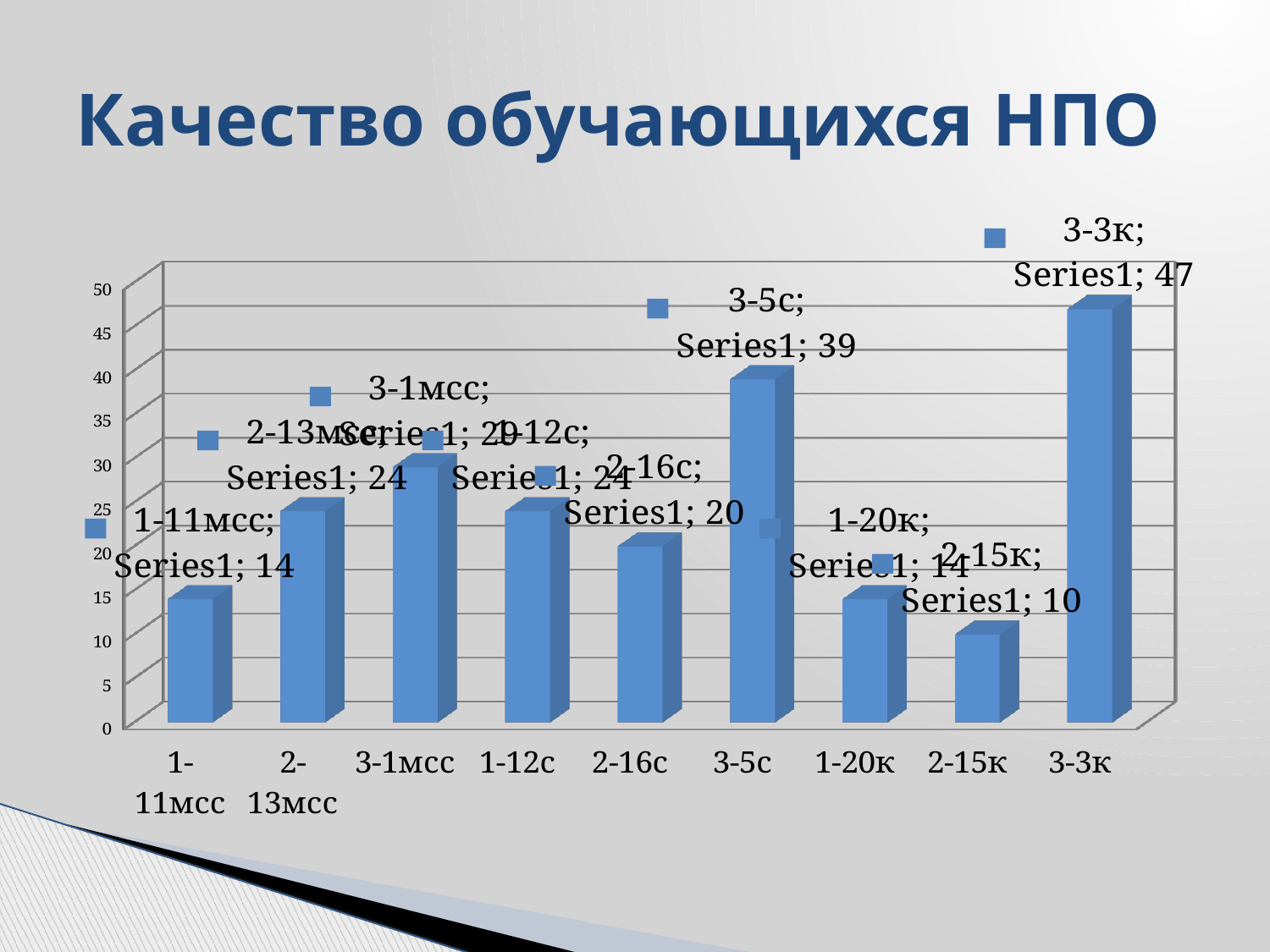
What is the value for 1-11мсс? 14 What kind of chart is shown on the slide? bar chart Which category has the lowest value? 2-15к Is the value for 3-1мсс greater or less than 25? greater What is the difference between the values for 3-3к and 3-5с? 8 How many categories are shown on the x axis? 9 Which category has the highest value? 3-3к What is the value for 2-15к? 10 What is the value for 3-3к? 47 What is the value for 3-5с? 39 Which is larger, the value for 2-13мсс or the value for 1-20к? 2-13мсс What is the value for 2-16с? 20